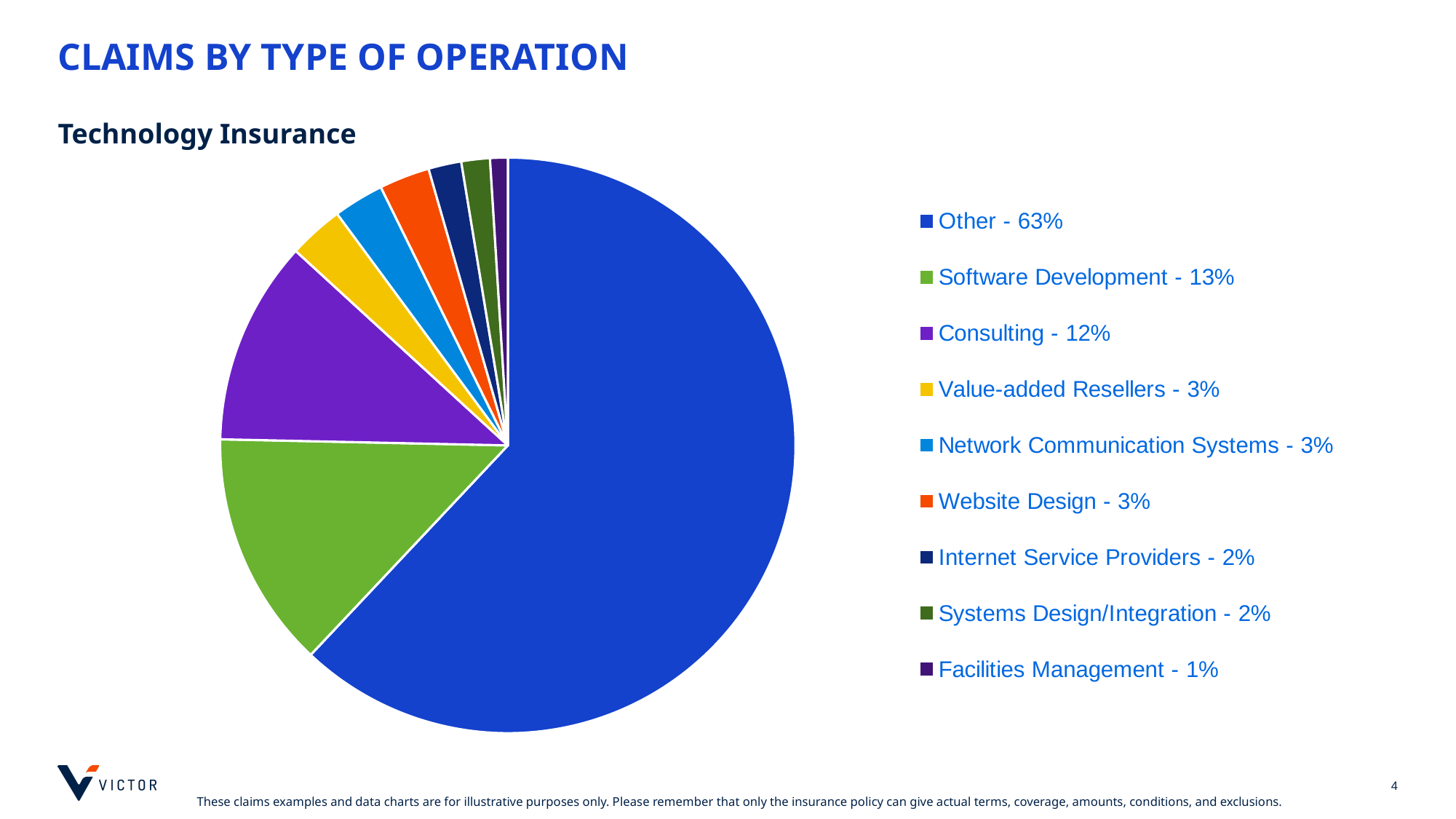
Which has a larger share of claims, Consulting or Value-added Resellers? Consulting What colour represents Website Design in the pie chart? Orange What type of chart is shown on the slide? Pie chart What is the subtitle shown above the pie chart? Technology Insurance What share of claims is attributed to Software Development? 13% Which category has the largest share of claims? Other What share of claims is attributed to Consulting? 12% Which category has the smallest share of claims? Facilities Management How many categories are shown in the pie chart? 9 What is the difference in share between Other and Software Development? 50% What is the combined share of Software Development and Consulting? 25% What share of claims is attributed to Facilities Management? 1%